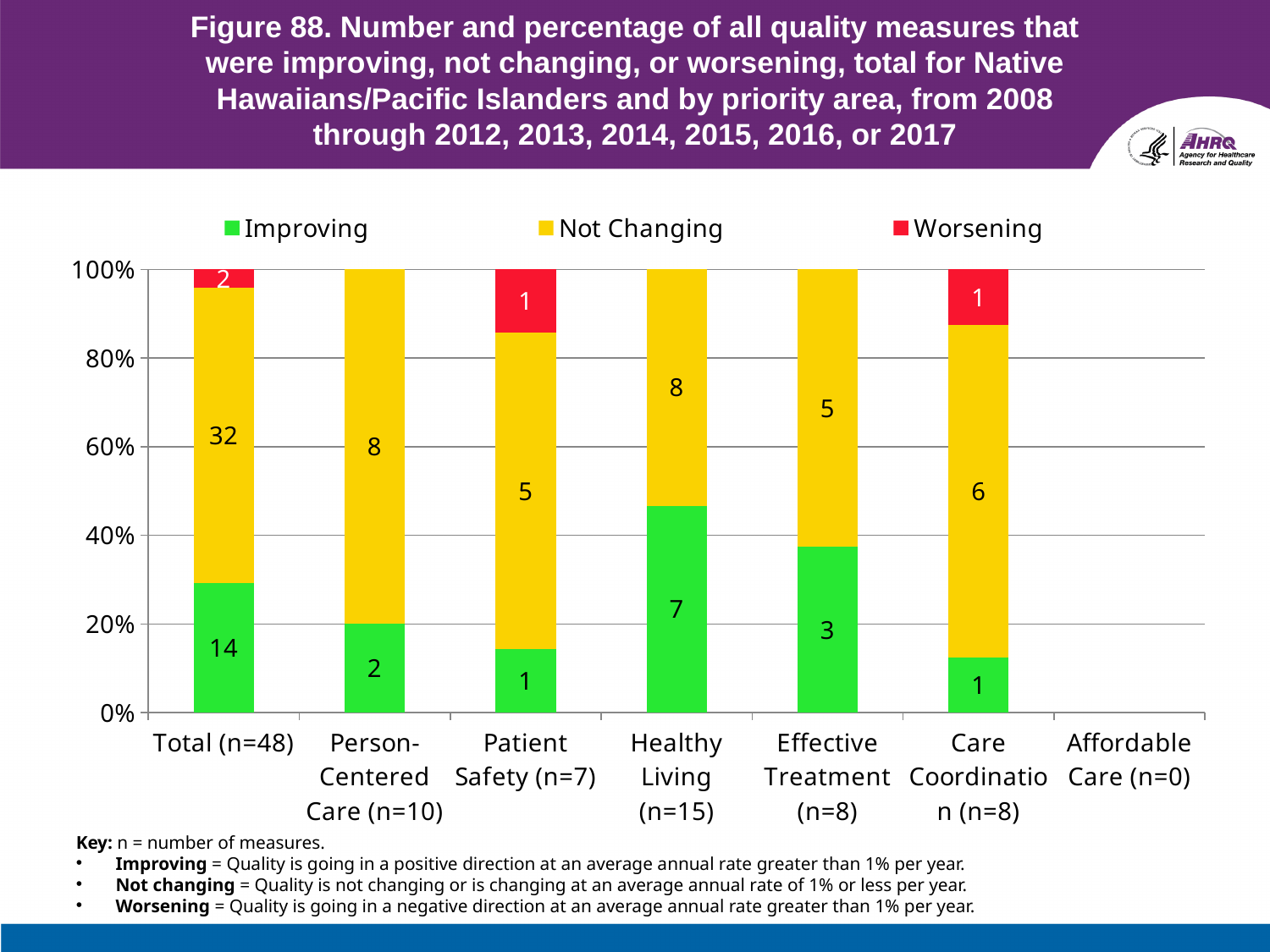
Which colour represents the Worsening series in the legend? Red Excluding Total, which priority area has the highest number of Improving measures? Healthy Living (n=15) What kind of chart is shown on the slide? Stacked bar chart How many series does the legend list? 3 What is the total number of measures in the Total (n=48) stacked bar? 48 How many priority-area categories are shown on the x axis, including Total? 7 How many quality measures were Worsening for Care Coordination (n=8)? 1 Which has more Improving measures, Effective Treatment (n=8) or Person-Centered Care (n=10)? Effective Treatment (n=8) What is the difference between the Not Changing and Improving counts for Total (n=48)? 18 Is the Improving share of the Healthy Living (n=15) bar greater or less than 40%? greater How many quality measures were Improving for Total (n=48)? 14 How many quality measures were Not Changing for Healthy Living (n=15)? 8